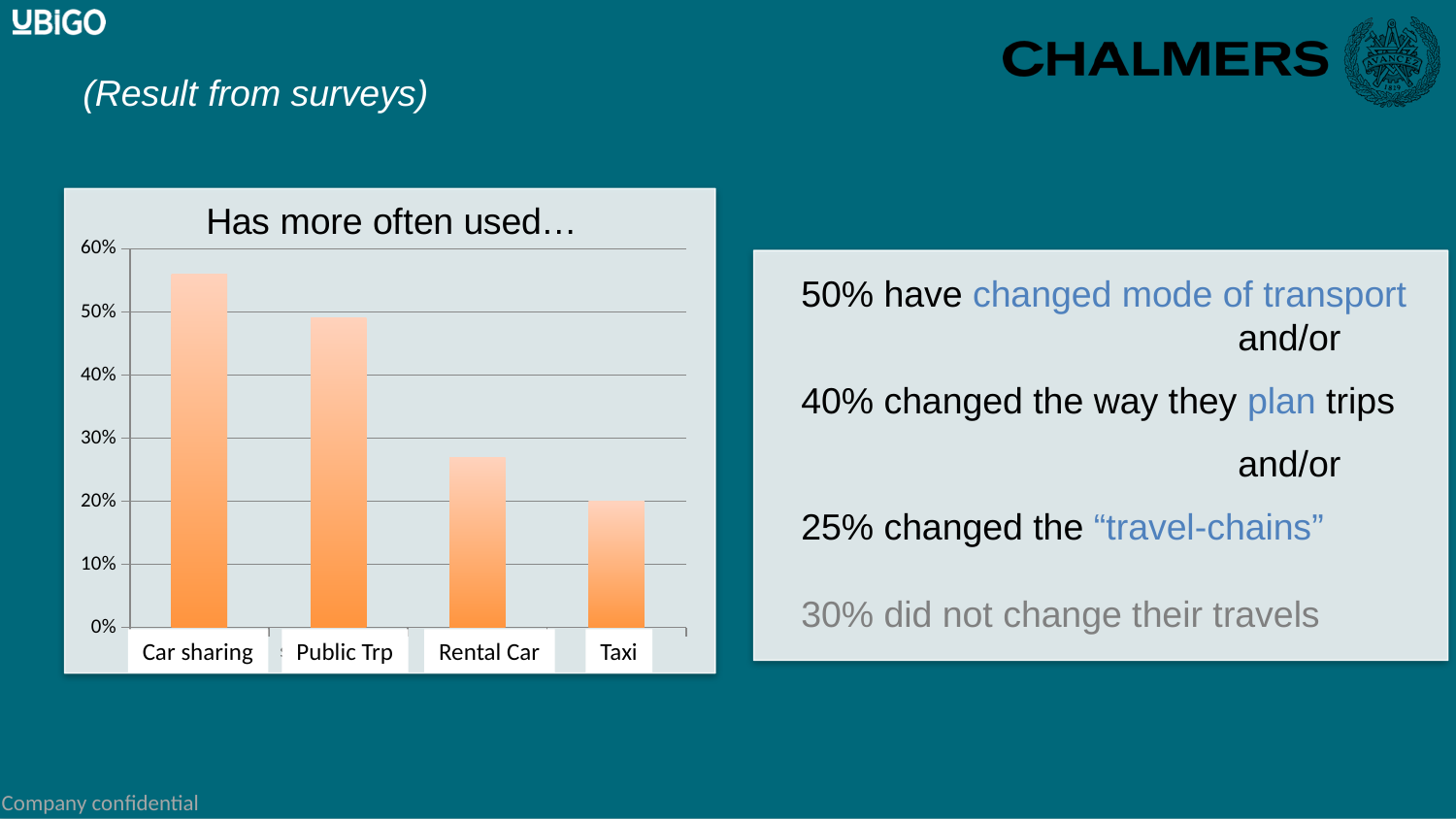
Which category has the lowest value in the chart? Taxi Is the value for Rental Car greater or less than 20%? greater Which is larger, the value for Public Trp or the value for Rental Car? Public Trp Do the values rise or fall from left to right across the categories? fall How many categories are shown in the chart? 4 Is the value for Car sharing greater or less than 50%? greater Which is larger, the value for Car sharing or the value for Public Trp? Car sharing Which category has the highest value in the chart? Car sharing What is the title of the chart? Has more often used… What kind of chart is shown on the slide? bar chart Is the value for Rental Car greater or less than 30%? less